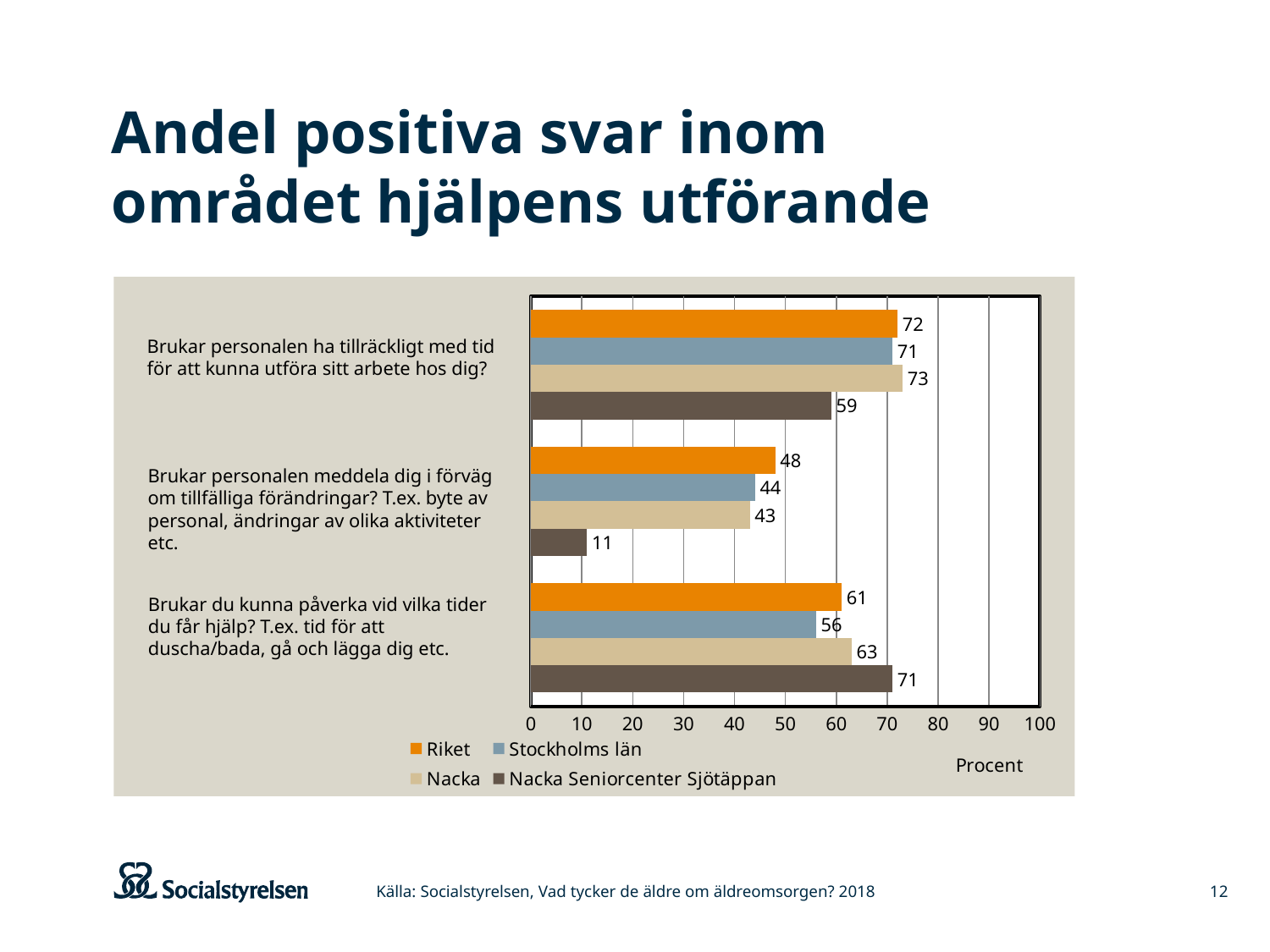
How many question categories are plotted on the chart? 3 Is the value for Nacka for "Brukar personalen meddela dig i förväg om tillfälliga förändringar?" greater or less than 50? less What is the difference between Riket and Nacka Seniorcenter Sjötäppan for "Brukar personalen meddela dig i förväg om tillfälliga förändringar?" 37 What kind of chart is shown on the slide? Bar chart What is the value for Riket for "Brukar personalen ha tillräckligt med tid för att kunna utföra sitt arbete hos dig?" 72 For "Brukar du kunna påverka vid vilka tider du får hjälp?", which is larger: Nacka or Riket? Nacka What is the label of the x axis? Procent Which series has the lowest value for "Brukar personalen ha tillräckligt med tid för att kunna utföra sitt arbete hos dig?" Nacka Seniorcenter Sjötäppan What is the value for Stockholms län for "Brukar du kunna påverka vid vilka tider du får hjälp?" 56 How many series does the legend list? 4 Which series has the highest value for "Brukar du kunna påverka vid vilka tider du får hjälp?" Nacka Seniorcenter Sjötäppan What is the value for Nacka Seniorcenter Sjötäppan for "Brukar personalen meddela dig i förväg om tillfälliga förändringar?" 11